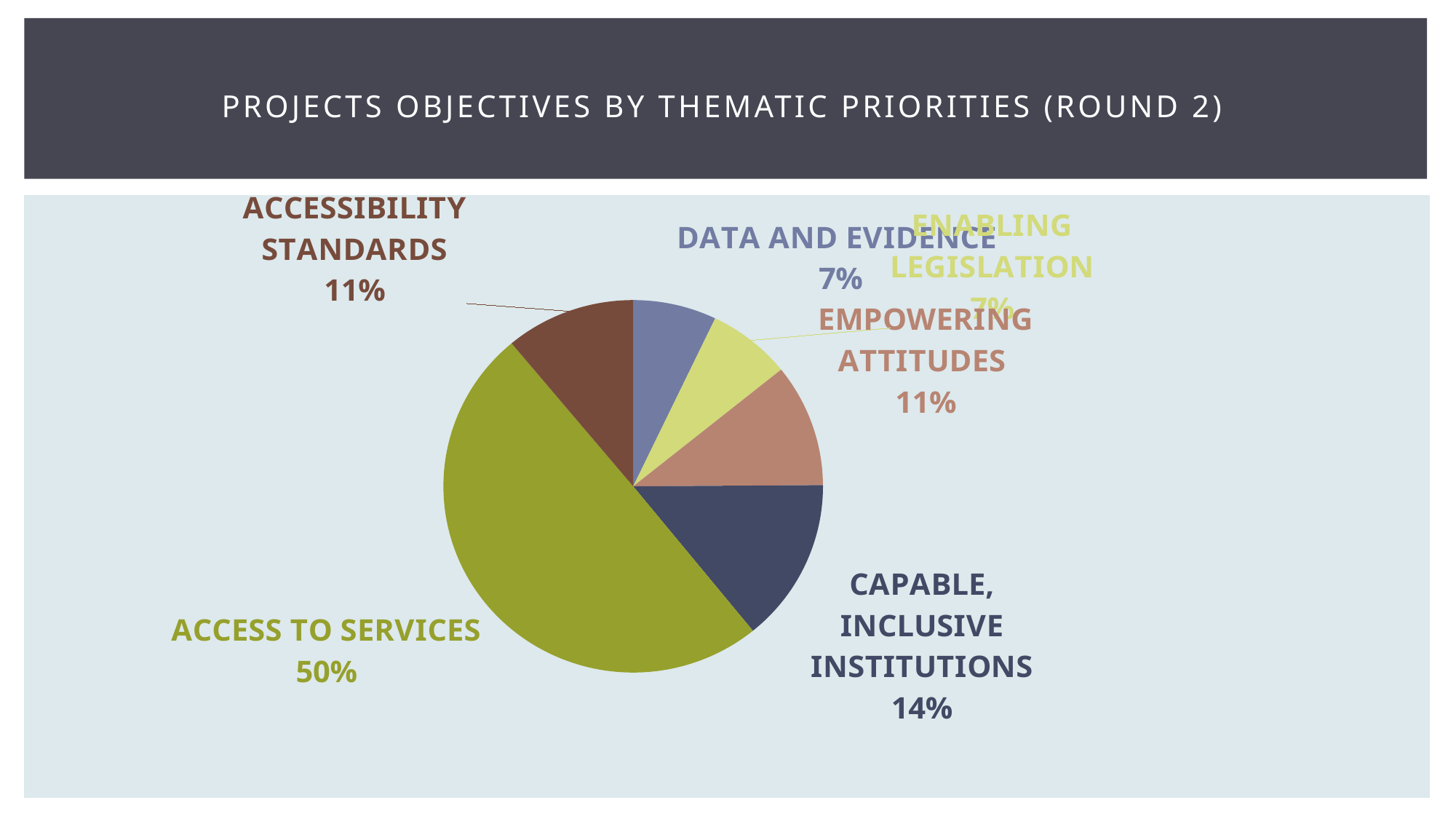
How many slices does the pie chart have? 6 What percentage is shown for Data and Evidence? 7% What is the difference in percentage points between Access to Services and Capable, Inclusive Institutions? 36 percentage points Which thematic priority has the largest share of the pie? Access to Services What is the title of the slide? Projects Objectives by Thematic Priorities (Round 2) What is the combined share of Accessibility Standards and Empowering Attitudes? 22% What percentage is shown for Capable, Inclusive Institutions? 14% What percentage is shown for Accessibility Standards? 11% Which has a larger share: Capable, Inclusive Institutions or Empowering Attitudes? Capable, Inclusive Institutions What percentage is shown for Empowering Attitudes? 11% What kind of chart is shown on the slide? Pie chart What percentage of project objectives falls under Access to Services? 50%